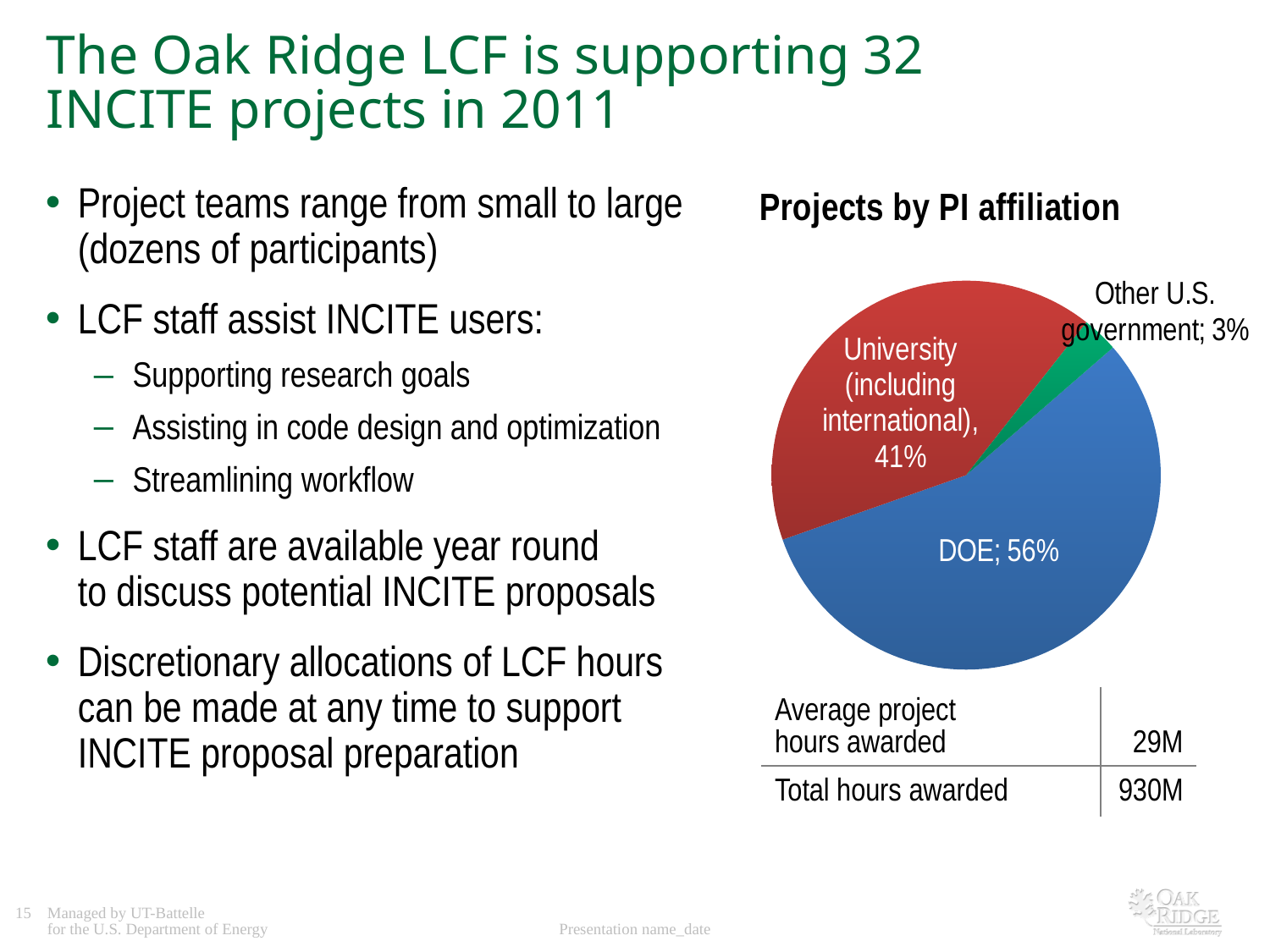
What share of projects have a DOE PI affiliation? 56% What is the difference in percentage points between the University and Other U.S. government shares? 38 percentage points What share of projects have a University (including international) PI affiliation? 41% What kind of chart is shown on the slide? Pie chart What colour is the DOE slice? Blue Which PI affiliation has the largest share of projects? DOE What share of projects have an Other U.S. government PI affiliation? 3% How many slices does the pie chart have? 3 Which PI affiliation has the smallest share of projects? Other U.S. government What is the difference in percentage points between the DOE and University shares? 15 percentage points Which is larger, the University share or the Other U.S. government share? University What is the title of the chart? Projects by PI affiliation